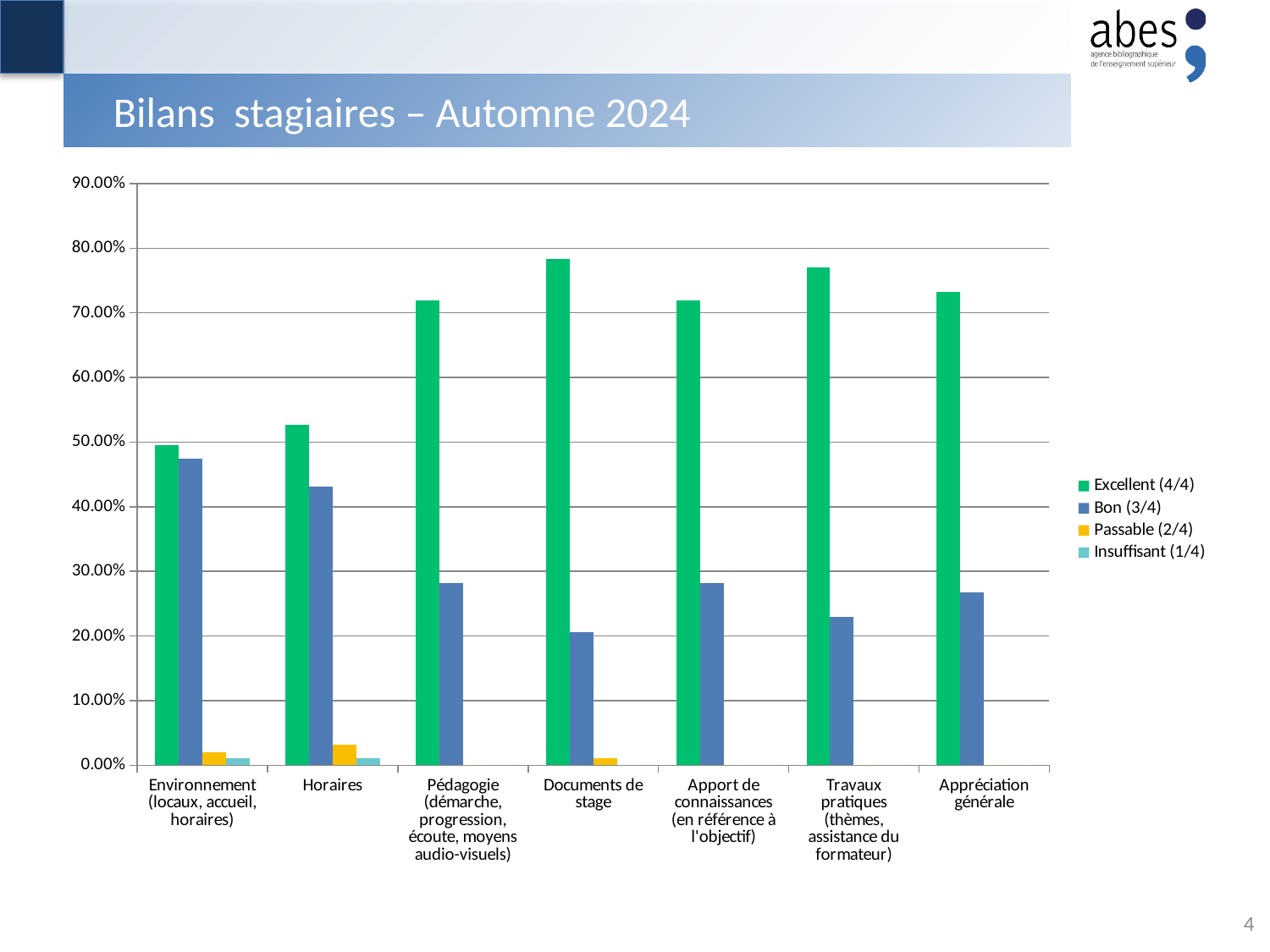
Which category has the highest value for the Bon (3/4) series? Environnement (locaux, accueil, horaires) How many categories are shown along the x axis? 7 Which category has the lowest value for the Excellent (4/4) series? Environnement (locaux, accueil, horaires) How many series does the legend list? 4 Which category has the lowest value for the Bon (3/4) series? Documents de stage Is the Bon (3/4) value for Appréciation générale greater or less than 30.00%? less Is the Excellent (4/4) value for Pédagogie greater or less than 70.00%? greater Is the Bon (3/4) value for Horaires greater or less than 40.00%? greater What kind of chart is shown on the slide? bar chart For Horaires, which is larger: the Excellent (4/4) value or the Bon (3/4) value? Excellent (4/4) What is the title of the slide containing the chart? Bilans stagiaires – Automne 2024